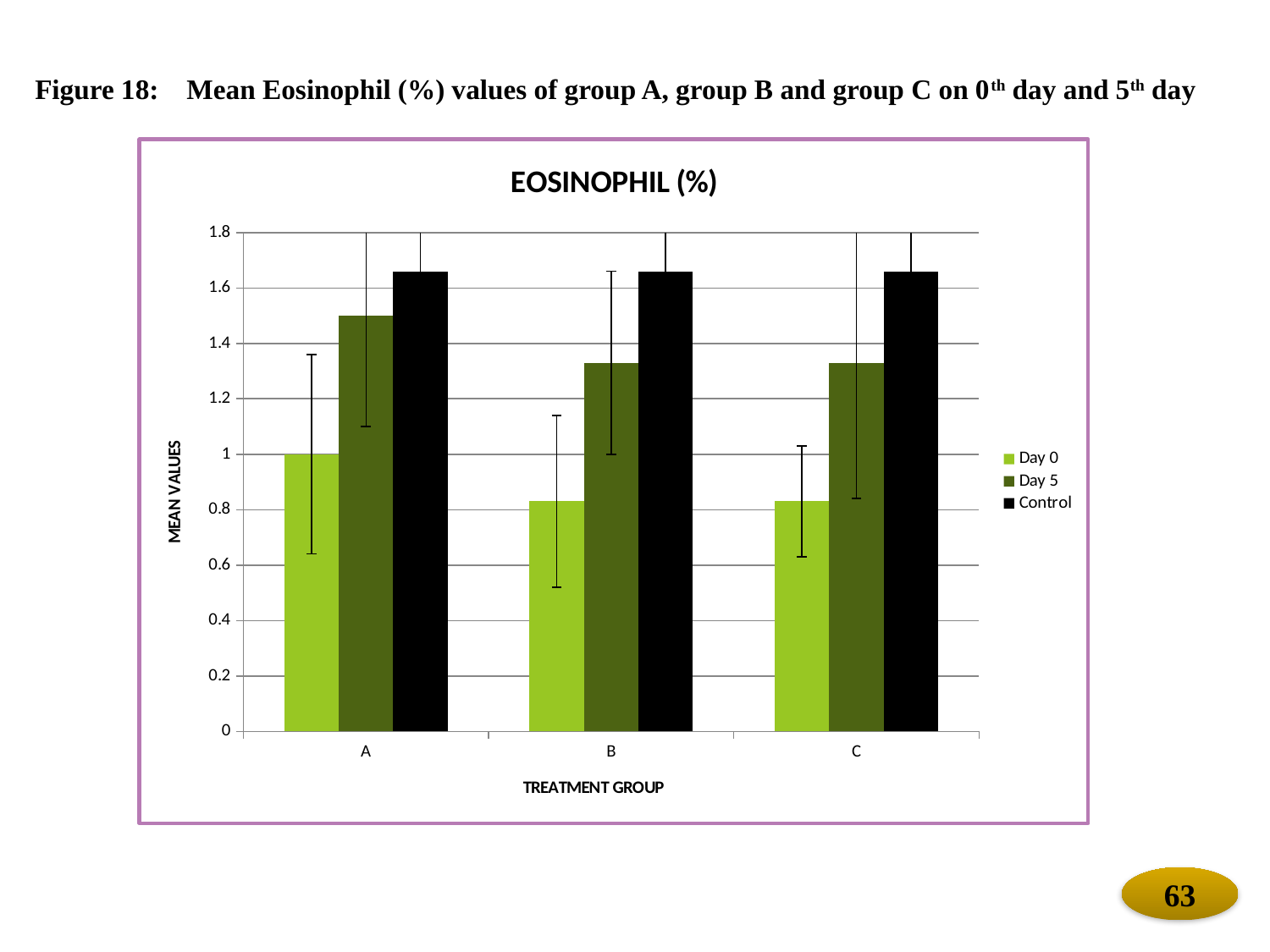
How many series does the legend list? 3 Is the Day 0 value for treatment group B greater or less than 1? less Which series has the highest value for treatment group A? Control Which is larger, the Day 5 value for group A or the Day 5 value for group B? group A How many treatment groups are shown on the x axis? 3 Is the Day 5 value for treatment group A greater or less than 1.4? greater Is the Control value for treatment group C greater or less than 1.6? greater What is the label of the y axis? MEAN VALUES What is the Day 0 value for treatment group A? 1 Which series has the lowest value for treatment group B? Day 0 What type of chart is shown on the slide? bar chart What is the title of the chart? EOSINOPHIL (%)